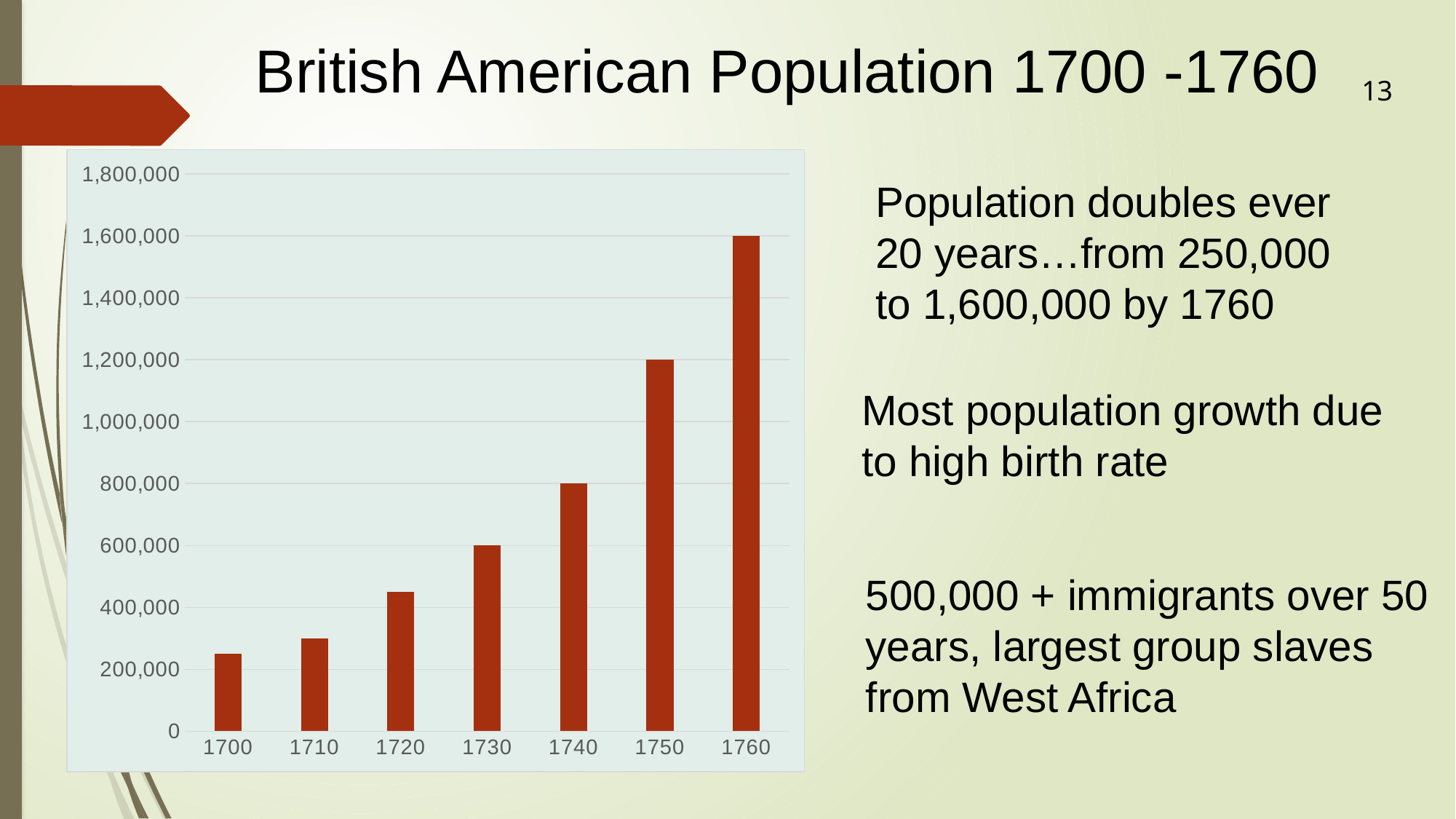
What is the population value for 1760? 1,600,000 Is the value for 1710 greater or less than 400,000? less What is the difference between the population in 1760 and in 1750? 400,000 Do the population values rise or fall from 1700 to 1760? rise What is the population value for 1750? 1,200,000 What is the title of the chart on the slide? British American Population 1700 -1760 What kind of chart is shown on the slide? bar chart What is the population value for 1730? 600,000 What is the population value for 1740? 800,000 How many years are plotted on the x axis of the chart? 7 Which year has the lowest population in the chart? 1700 Which year has the highest population in the chart? 1760